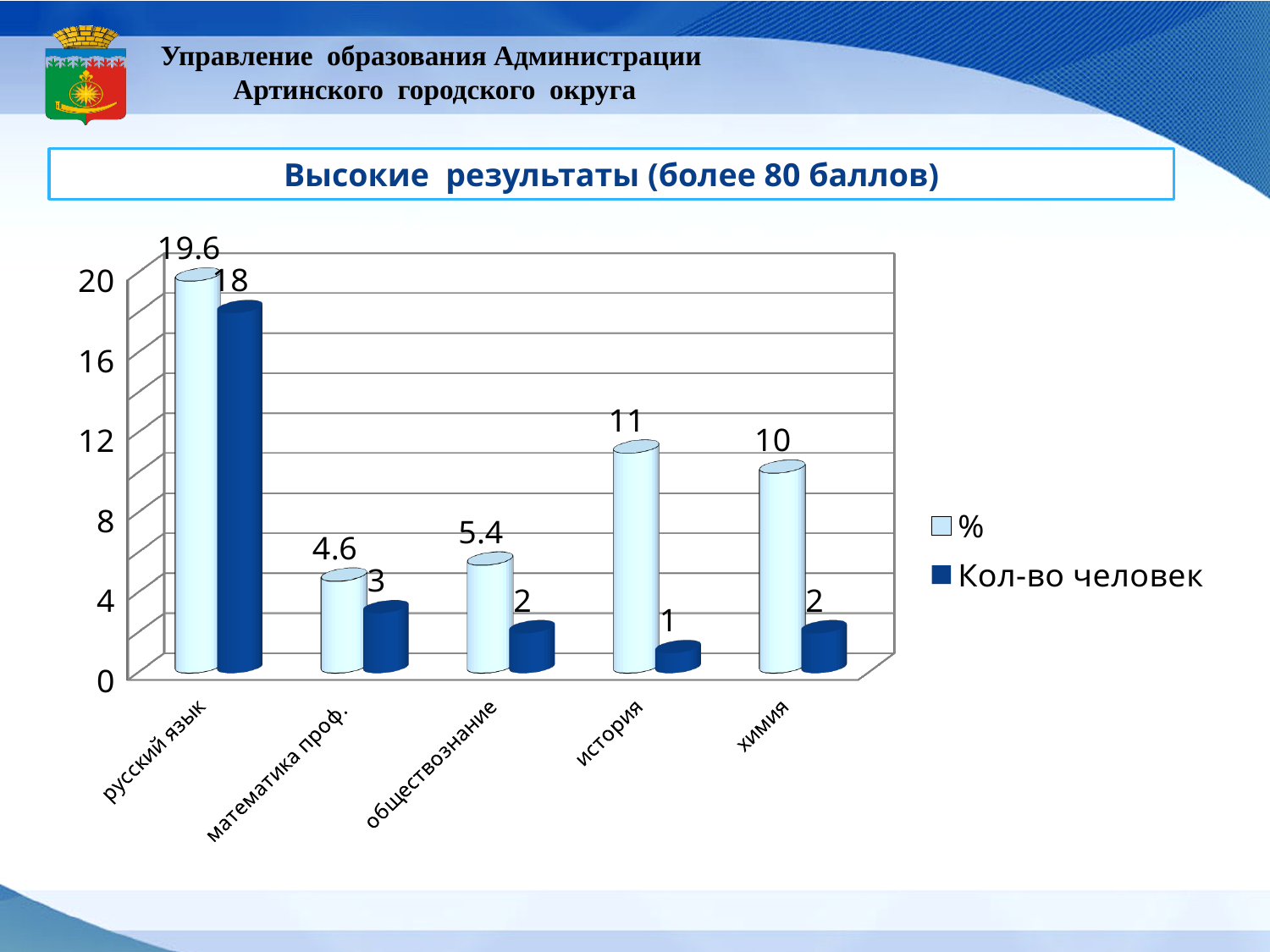
What is the title of the chart? Высокие результаты (более 80 баллов) How many categories are shown on the x axis? 5 What is the % value for русский язык? 19.6 Which category has the lowest Кол-во человек value? история What kind of chart is shown on the slide? bar chart Which is larger, the % value for математика проф. or for обществознание? обществознание What is the Кол-во человек value for математика проф.? 3 What is the Кол-во человек value for история? 1 What is the difference between the % values for история and обществознание? 5.6 How many series does the legend list? 2 Which category has the highest % value? русский язык What is the % value for химия? 10